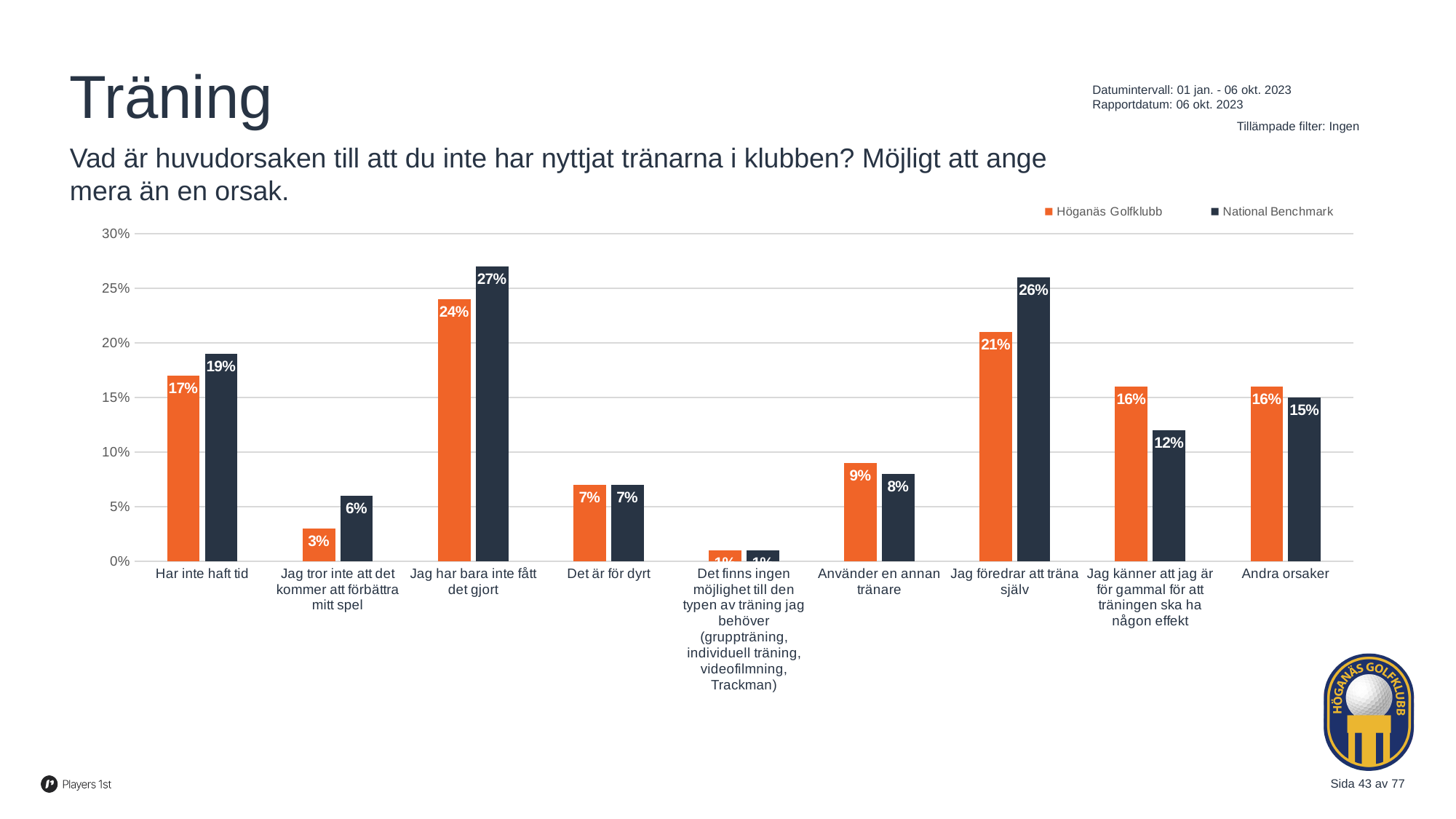
Which category has the lowest National Benchmark value? Det finns ingen möjlighet till den typen av träning jag behöver (gruppträning, individuell träning, videofilmning, Trackman) What is the Höganäs Golfklubb value for "Jag föredrar att träna själv"? 21% How many categories are shown on the x axis? 9 What is the difference between the National Benchmark and Höganäs Golfklubb values for "Jag känner att jag är för gammal för att träningen ska ha någon effekt"? 4% For "Andra orsaker", which series has the larger value, Höganäs Golfklubb or National Benchmark? Höganäs Golfklubb What kind of chart is shown on the slide? Bar chart What is the National Benchmark value for "Jag har bara inte fått det gjort"? 27% How many series does the legend list? 2 Is the National Benchmark value for "Jag föredrar att träna själv" greater or less than 25%? greater Which category has the highest Höganäs Golfklubb value? Jag har bara inte fått det gjort What is the value for Höganäs Golfklubb for "Har inte haft tid"? 17% Which colour represents National Benchmark in the chart? Dark navy